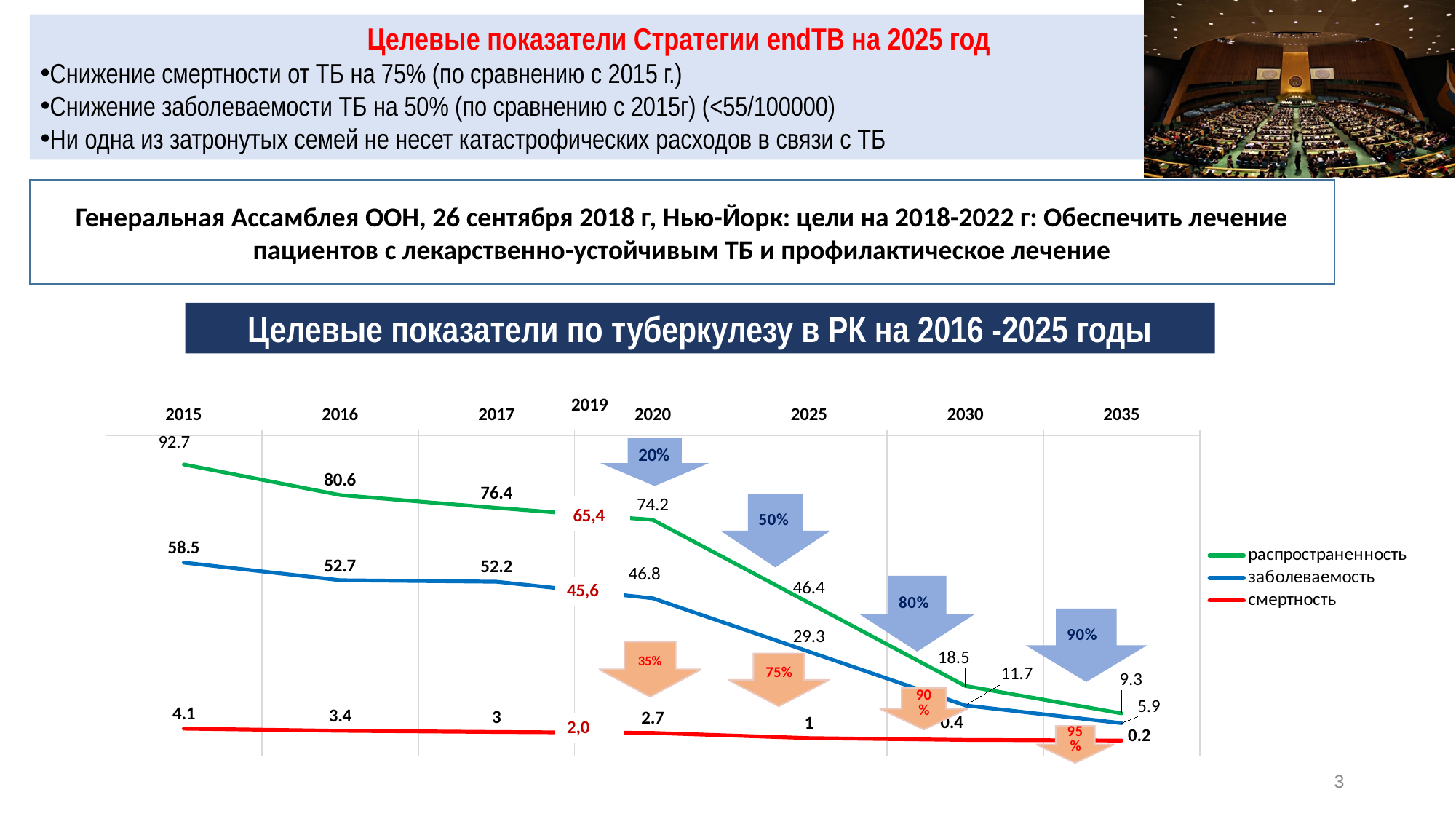
What is the value of смертность in 2030? 0.4 What is the value of распространенность in 2015? 92.7 What is the difference between распространенность in 2015 and in 2035? 83.4 What is the value of заболеваемость in 2025? 29.3 What colour is the смертность line in the legend? red In which year is заболеваемость lowest? 2035 In which year is распространенность highest? 2015 What kind of chart is shown on the slide? line chart Which is larger in 2020: распространенность or заболеваемость? распространенность Does смертность rise or fall from 2015 to 2035? fall How many series does the chart legend list? 3 What is the value of смертность in 2016? 3.4